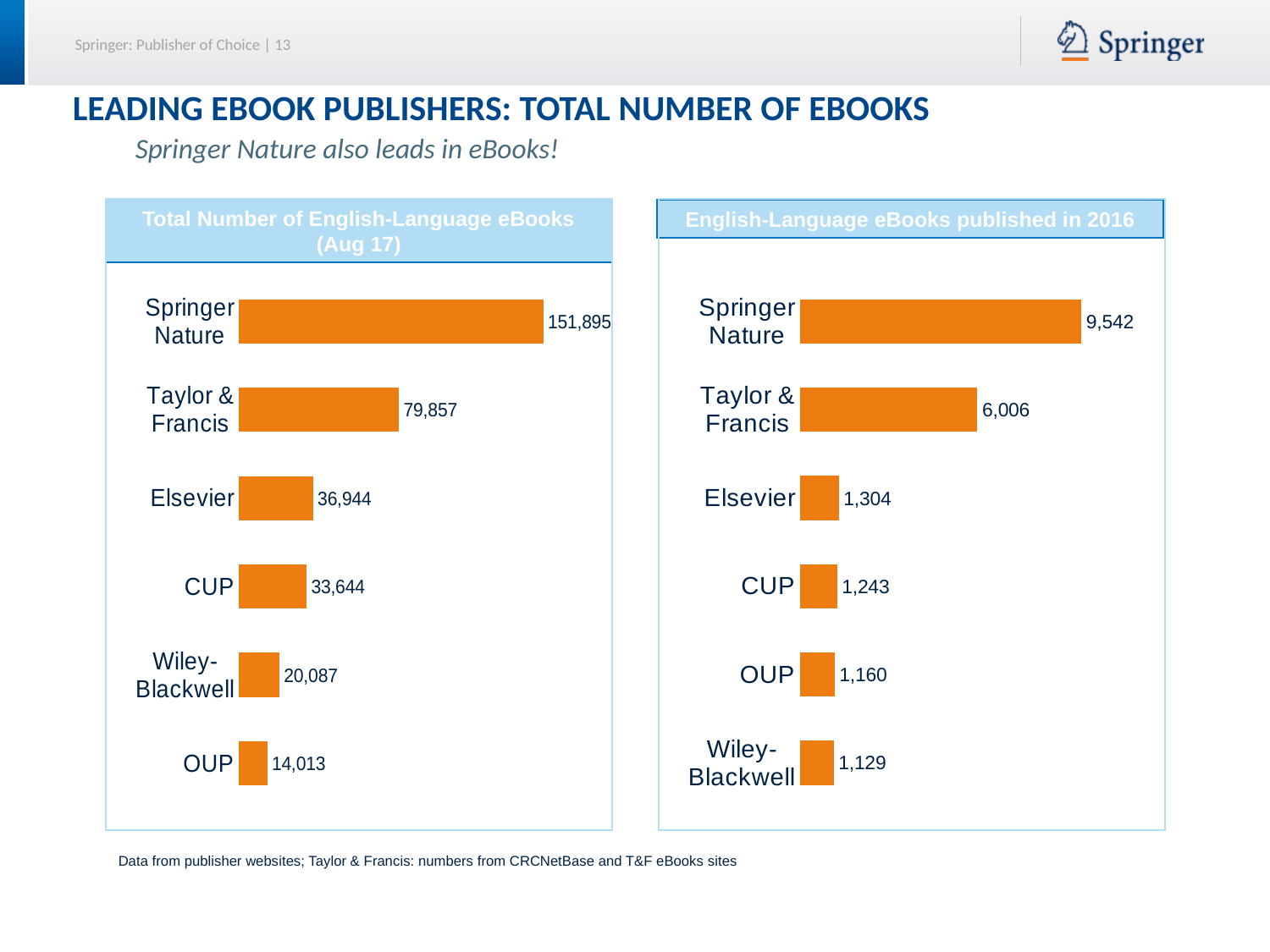
In the 'English-Language eBooks published in 2016' chart, what is the value for CUP? 1,243 What is the title of the chart on the right side of the slide? English-Language eBooks published in 2016 What type of chart is the 'Total Number of English-Language eBooks (Aug 17)' chart? Bar chart How many publishers are shown in the 'English-Language eBooks published in 2016' chart? 6 In the 'English-Language eBooks published in 2016' chart, which publisher has the highest value? Springer Nature In the 'Total Number of English-Language eBooks (Aug 17)' chart, which publisher has the lowest value? OUP In the 'English-Language eBooks published in 2016' chart, what is the difference between Elsevier and CUP? 61 In the 'Total Number of English-Language eBooks (Aug 17)' chart, what is the difference between Springer Nature and Taylor & Francis? 72,038 In the 'Total Number of English-Language eBooks (Aug 17)' chart, what is the value for Springer Nature? 151,895 In the 'English-Language eBooks published in 2016' chart, what is the value for Taylor & Francis? 6,006 In the 'Total Number of English-Language eBooks (Aug 17)' chart, which is larger, Elsevier or CUP? Elsevier In the 'Total Number of English-Language eBooks (Aug 17)' chart, what is the value for Wiley-Blackwell? 20,087